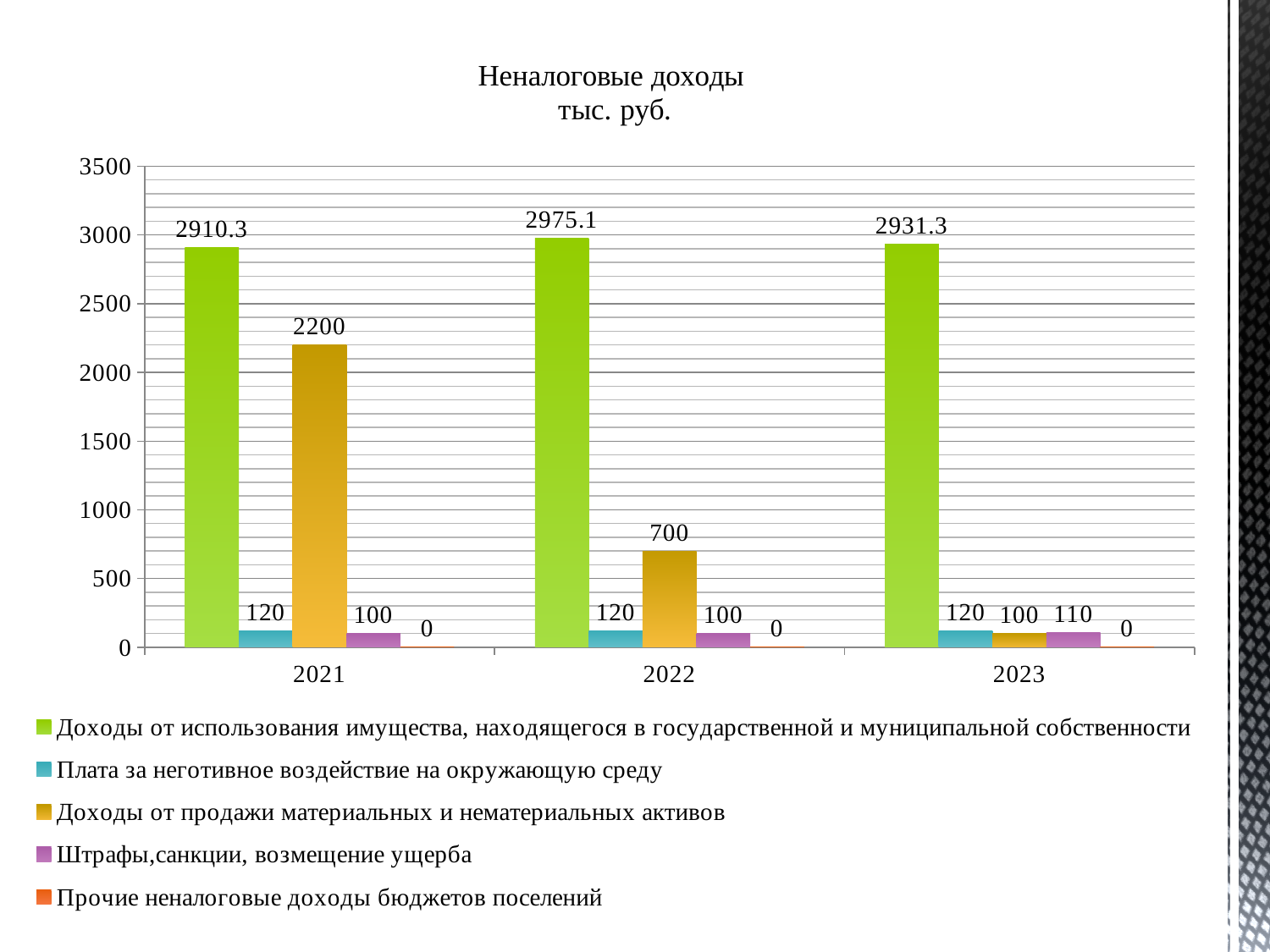
What is the value of 'Доходы от продажи материальных и нематериальных активов' for 2021? 2200 What is the value of 'Прочие неналоговые доходы бюджетов поселений' for 2022? 0 Which is larger in 2023: 'Плата за неготивное воздействие на окружающую среду' or 'Доходы от продажи материальных и нематериальных активов'? Плата за неготивное воздействие на окружающую среду How many years are shown on the x axis? 3 What is the value of 'Штрафы,санкции, возмещение ущерба' for 2023? 110 What type of chart is shown on the slide? bar chart In which year is 'Доходы от продажи материальных и нематериальных активов' lowest? 2023 What is the value of 'Доходы от использования имущества, находящегося в государственной и муниципальной собственности' for 2022? 2975.1 What is the difference between 'Доходы от продажи материальных и нематериальных активов' in 2021 and in 2022? 1500 How many series does the legend list? 5 In which year is 'Доходы от использования имущества, находящегося в государственной и муниципальной собственности' highest? 2022 What is the title of the chart? Неналоговые доходы тыс. руб.